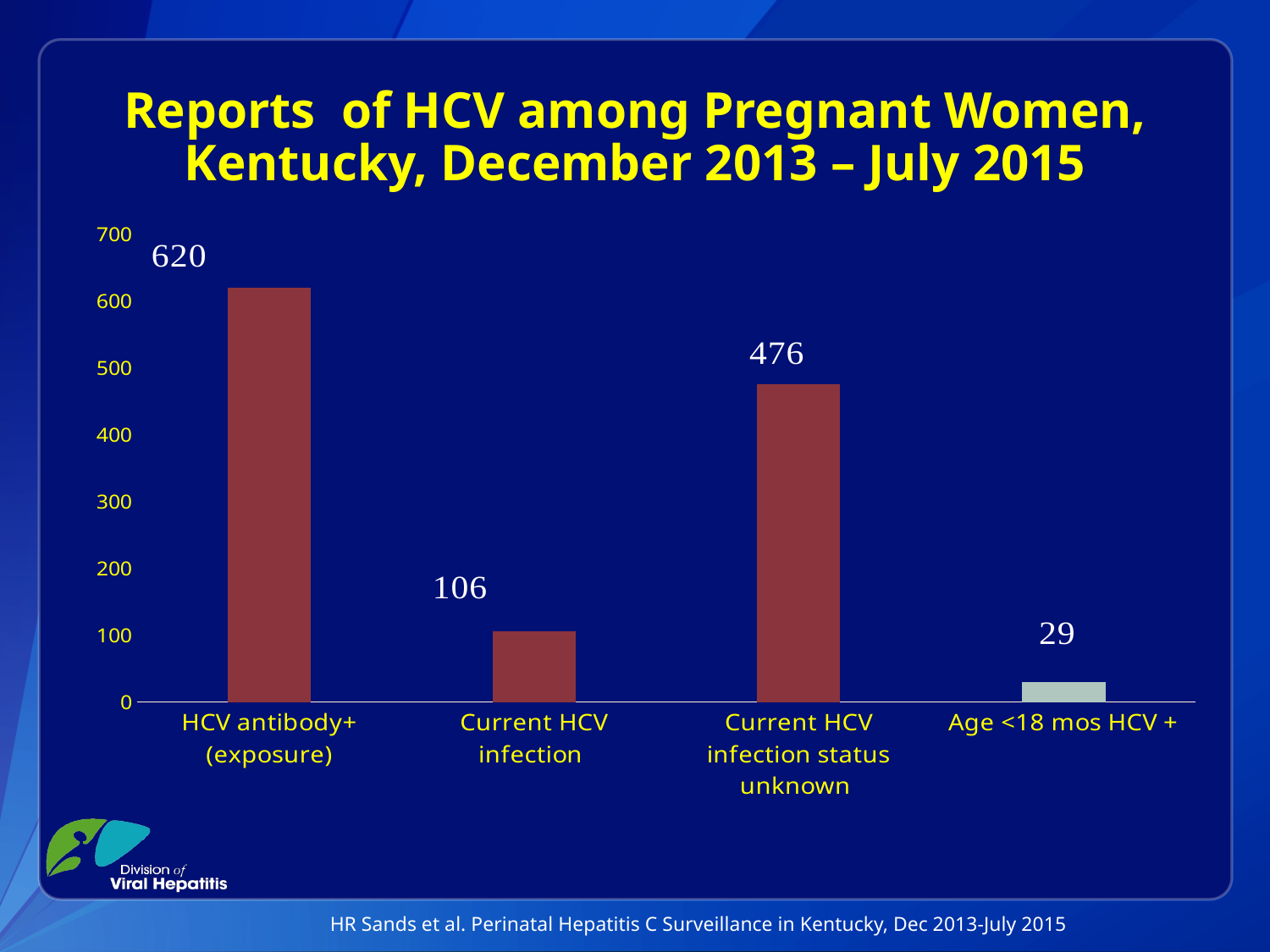
Which is larger, Current HCV infection or Current HCV infection status unknown? Current HCV infection status unknown What is the value for Age <18 mos HCV +? 29 How many categories are shown on the chart? 4 What is the difference between HCV antibody+ (exposure) and Current HCV infection status unknown? 144 Which category has the highest value? HCV antibody+ (exposure) What is the value for HCV antibody+ (exposure)? 620 What is the difference between Current HCV infection and Age <18 mos HCV +? 77 What is the title of the chart? Reports of HCV among Pregnant Women, Kentucky, December 2013 – July 2015 Which category has the lowest value? Age <18 mos HCV + What kind of chart is shown on the slide? Bar chart What is the value for Current HCV infection status unknown? 476 What is the value for Current HCV infection? 106